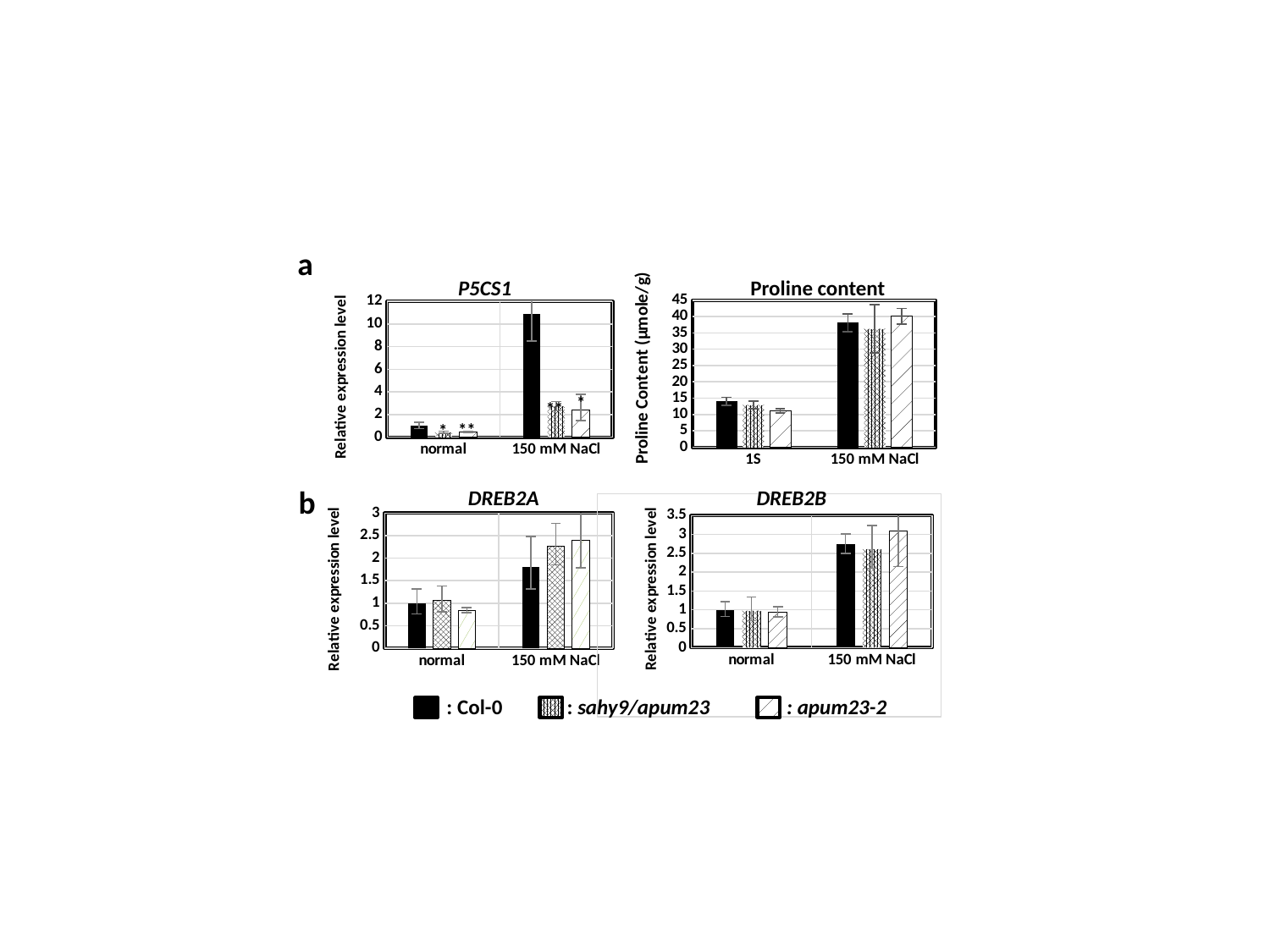
In the Proline content chart, is the value for Col-0 at 150 mM NaCl greater or less than 30? greater In the DREB2A chart, which is larger for Col-0: the value at normal or at 150 mM NaCl? 150 mM NaCl In the DREB2B chart, is the value for apum23-2 at 150 mM NaCl greater or less than 2.5? greater What is the y-axis label of the Proline content chart? Proline Content (µmole/g) In the Proline content chart, is the value for apum23-2 at 1S greater or less than 15? less In the P5CS1 chart, how many categories are shown on the x axis? 2 How many series does the shared legend at the bottom of the slide list? 3 In the Proline content chart, which is larger for Col-0: the value at 1S or at 150 mM NaCl? 150 mM NaCl In the P5CS1 chart, which bar is the highest? Col-0 at 150 mM NaCl What kind of chart is the P5CS1 chart? bar chart